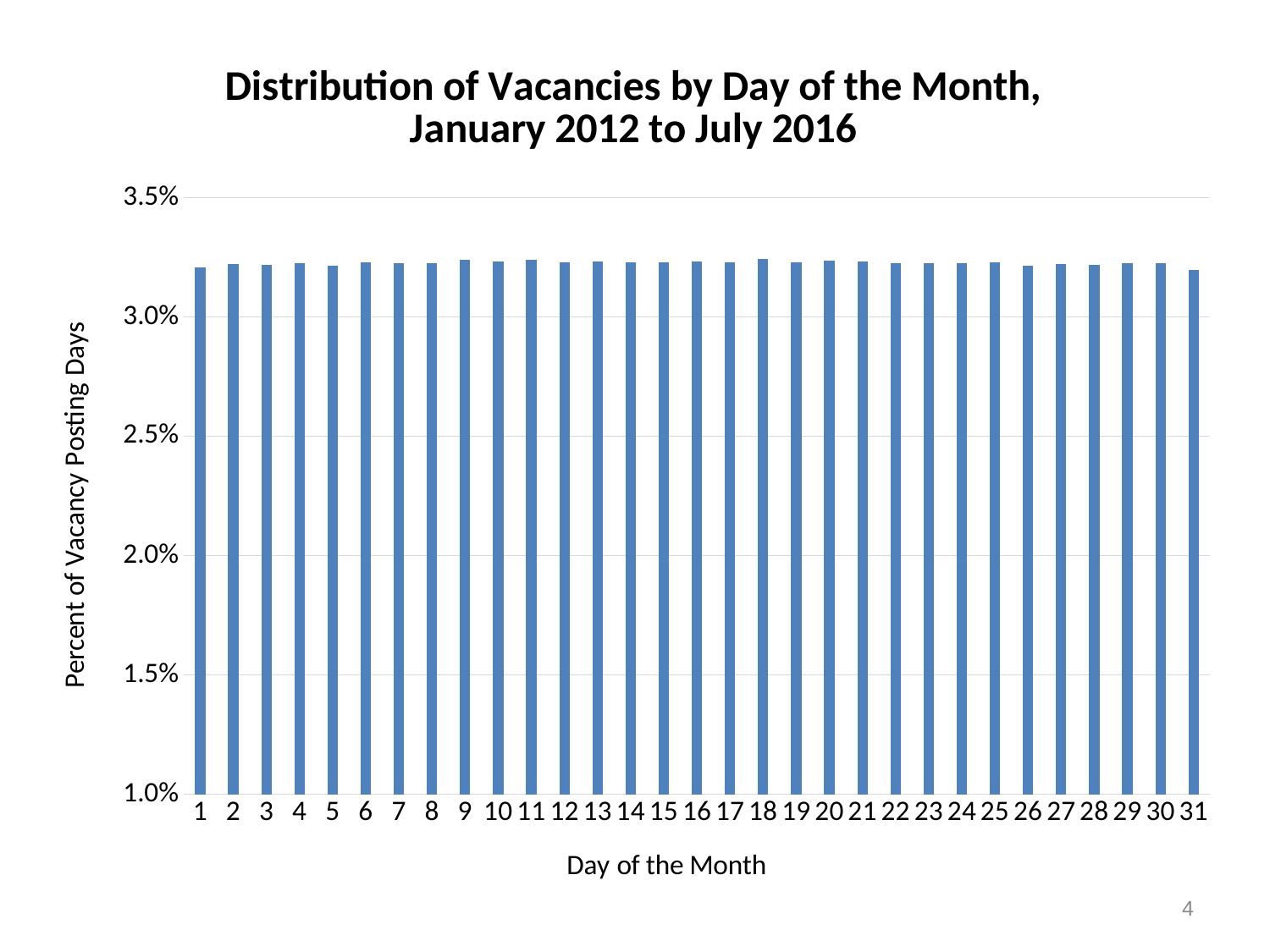
Is the value for day 18 greater or less than 3.5%? less What is the title of the chart? Distribution of Vacancies by Day of the Month, January 2012 to July 2016 Is the value for day 15 greater or less than 2.5%? greater What kind of chart is shown on the slide? bar chart Are any of the bars below 3.0%? No What is the lowest value shown on the y axis? 1.0% How many days of the month are plotted on the x axis? 31 What is the label of the y axis? Percent of Vacancy Posting Days